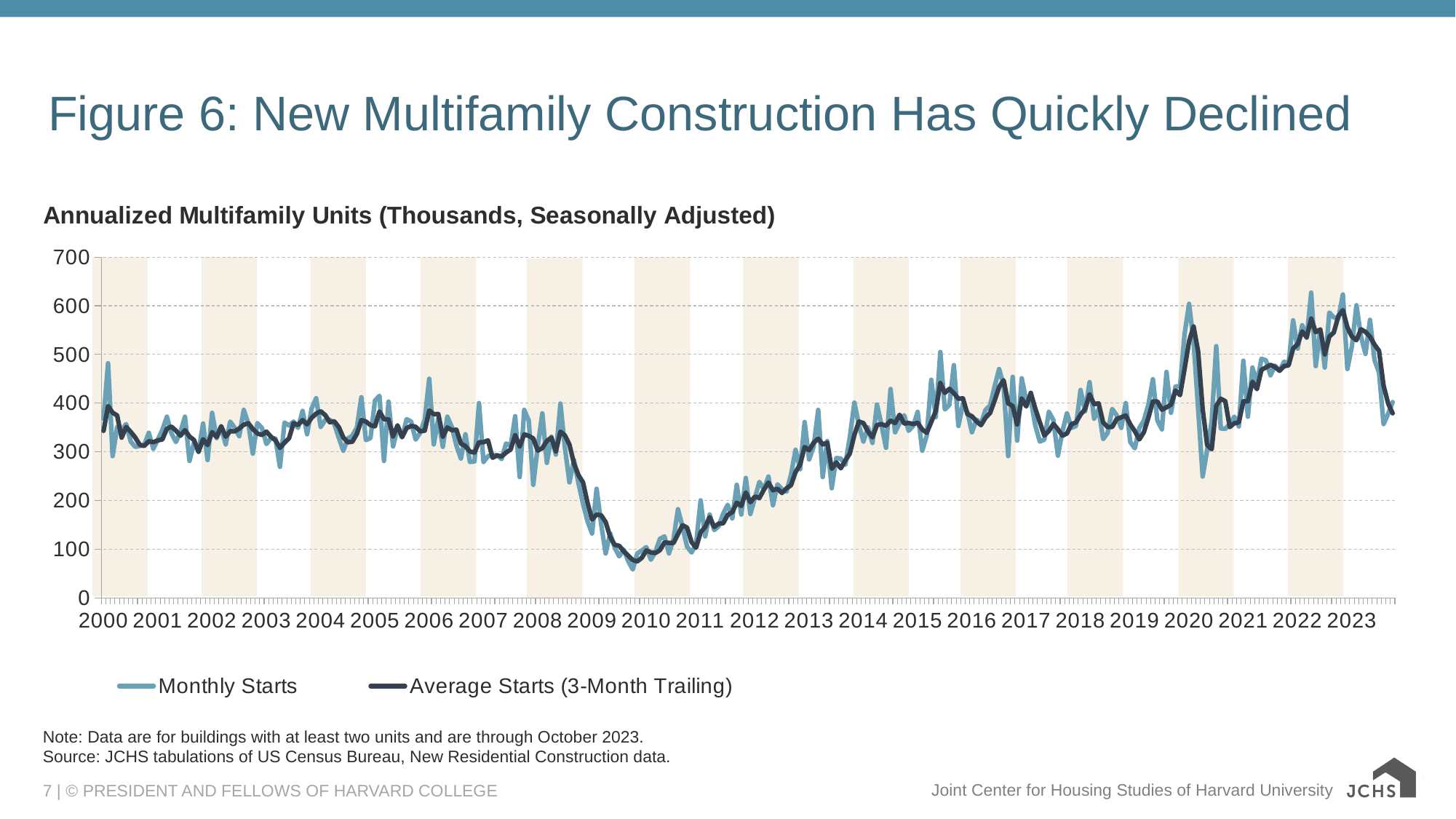
Is the peak of Average Starts (3-Month Trailing) in 2022 greater or less than 500? greater Do the Average Starts (3-Month Trailing) values rise or fall from 2010 to 2015? rise Is the value of Average Starts (3-Month Trailing) at the start of 2010 greater or less than 200? less Do the Average Starts (3-Month Trailing) values rise or fall from 2007 to 2009? fall What is the axis title shown above the chart? Annualized Multifamily Units (Thousands, Seasonally Adjusted) In which year does the Monthly Starts series reach its lowest point? 2009 Is the lowest value of Monthly Starts around 2009 greater or less than 100? less How many year labels are shown on the x axis? 24 What are the two series named in the legend? Monthly Starts; Average Starts (3-Month Trailing) What kind of chart is shown on the slide? line chart How many series does the legend list? 2